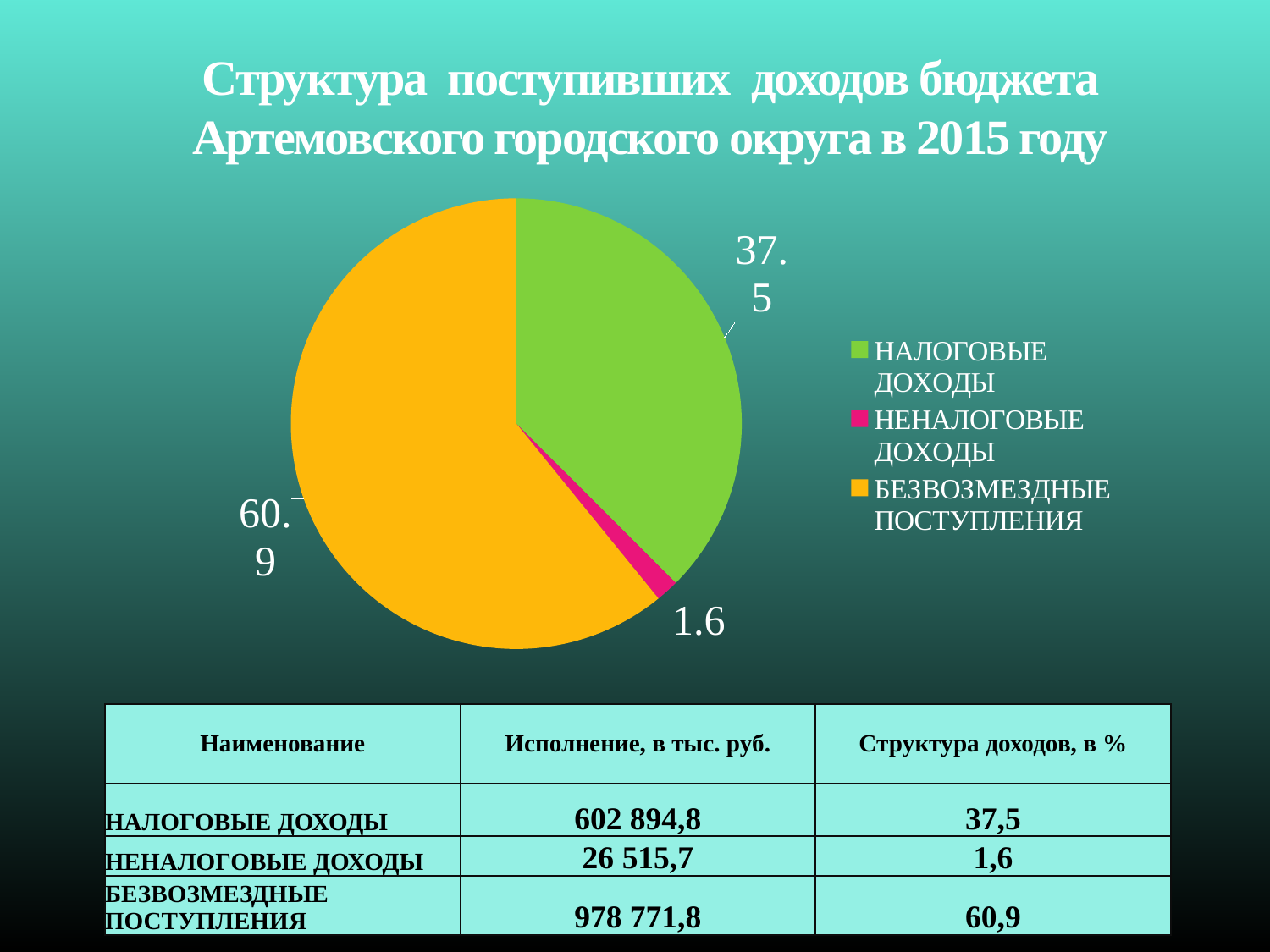
Which category has the largest slice in the pie chart? БЕЗВОЗМЕЗДНЫЕ ПОСТУПЛЕНИЯ How many slices does the pie chart have? 3 What is the value shown for БЕЗВОЗМЕЗДНЫЕ ПОСТУПЛЕНИЯ in the pie chart? 60.9 Which category has the smallest slice in the pie chart? НЕНАЛОГОВЫЕ ДОХОДЫ What is the value shown for НЕНАЛОГОВЫЕ ДОХОДЫ in the pie chart? 1.6 What kind of chart is shown on the slide? pie chart Which is larger in the pie chart: НАЛОГОВЫЕ ДОХОДЫ or НЕНАЛОГОВЫЕ ДОХОДЫ? НАЛОГОВЫЕ ДОХОДЫ What is the value shown for НАЛОГОВЫЕ ДОХОДЫ in the pie chart? 37.5 What colour is the slice for БЕЗВОЗМЕЗДНЫЕ ПОСТУПЛЕНИЯ in the pie chart? orange How many entries does the legend of the pie chart list? 3 What colour is the slice for НАЛОГОВЫЕ ДОХОДЫ in the pie chart? green What is the difference between the values for БЕЗВОЗМЕЗДНЫЕ ПОСТУПЛЕНИЯ and НАЛОГОВЫЕ ДОХОДЫ in the pie chart? 23.4